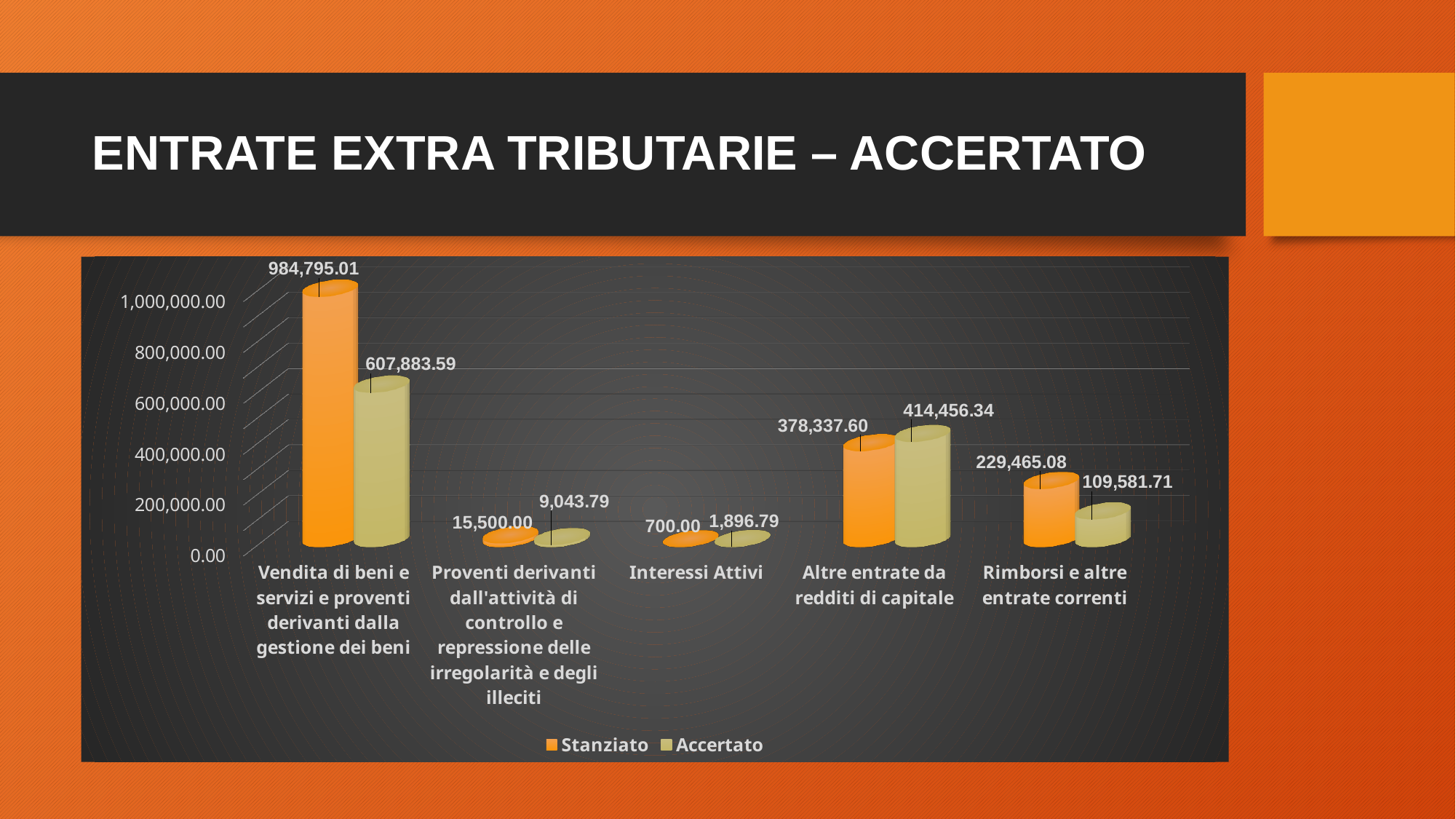
What is the Accertato value for Interessi Attivi? 1,896.79 What is the difference between the Accertato and Stanziato values for Altre entrate da redditi di capitale? 36,118.74 What is the Stanziato value for Rimborsi e altre entrate correnti? 229,465.08 What kind of chart is shown on the slide? Bar chart What is the Accertato value for Altre entrate da redditi di capitale? 414,456.34 What is the Stanziato value for Vendita di beni e servizi e proventi derivanti dalla gestione dei beni? 984,795.01 Which category has the highest Accertato value? Vendita di beni e servizi e proventi derivanti dalla gestione dei beni Which category has the lowest Stanziato value? Interessi Attivi What is the difference between the Stanziato and Accertato values for Vendita di beni e servizi e proventi derivanti dalla gestione dei beni? 376,911.42 How many categories are shown on the x axis? 5 How many series does the legend list? 2 For Rimborsi e altre entrate correnti, which is larger: Stanziato or Accertato? Stanziato